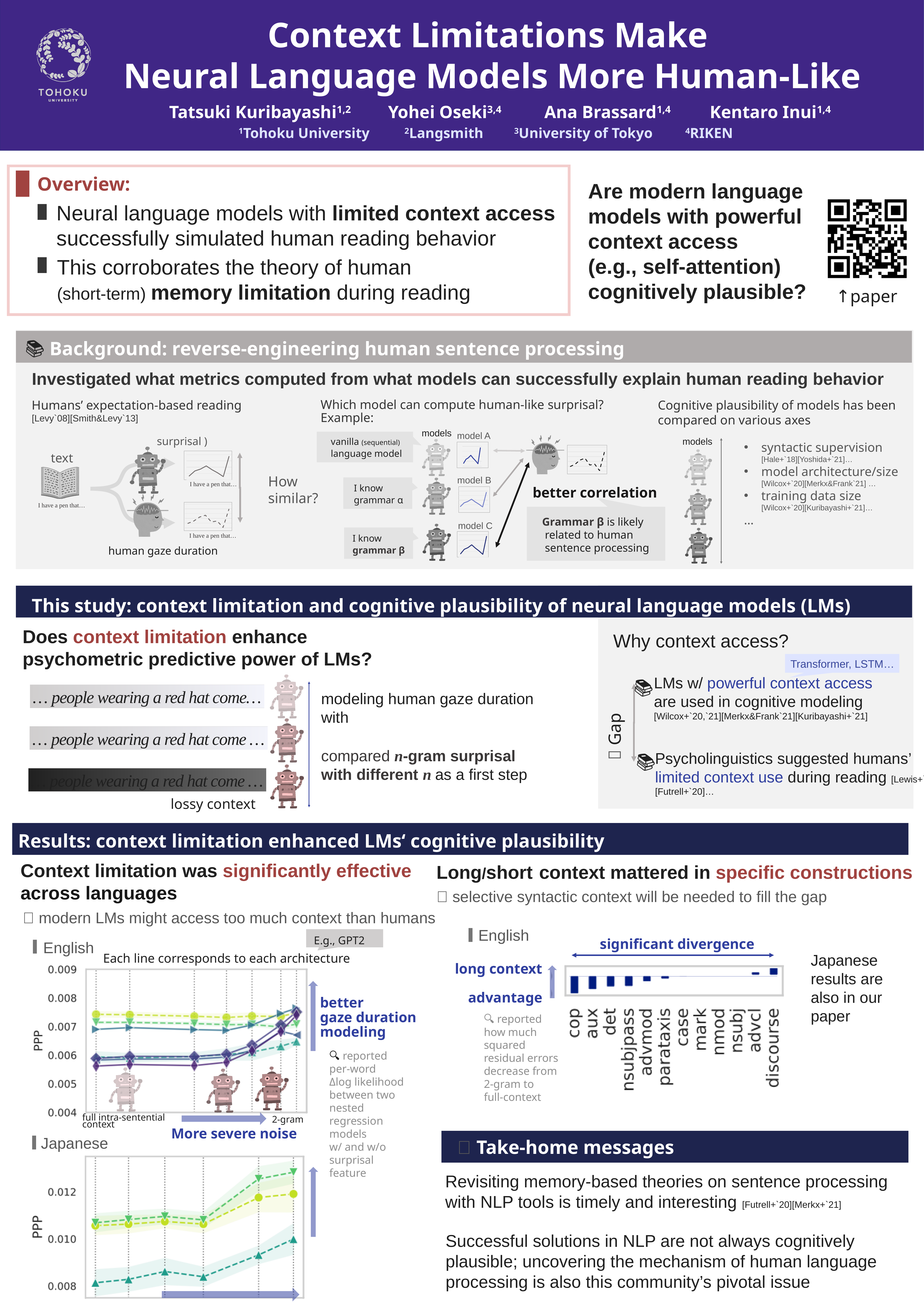
How many syntactic constructions are shown on the x axis of the bar chart on the right? 12 In the bar chart of syntactic constructions, which construction has the lowest value (largest bar below the baseline)? cop What kind of chart is the chart of syntactic constructions (cop, aux, det, ...) on the right? bar chart What kind of chart is the English PPP chart on the lower left? line chart In the bar chart of syntactic constructions, which construction has the largest long-context advantage? discourse In the English PPP chart, is the value of the topmost line at the leftmost point (full intra-sentential context) greater or less than 0.007? greater In the English PPP chart, do the lines generally rise or fall moving from full intra-sentential context toward 2-gram? rise In the Japanese PPP chart, do the lines rise or fall moving from left to right along the x axis? rise In the English PPP chart, is the value of the lowest line at the leftmost point greater or less than 0.006? less In the Japanese PPP chart, is the value of the topmost line at the rightmost point greater or less than 0.012? greater What is the label on the y axis of the English and Japanese line charts? PPP In the bar chart of syntactic constructions, which has the larger value, cop or discourse? discourse